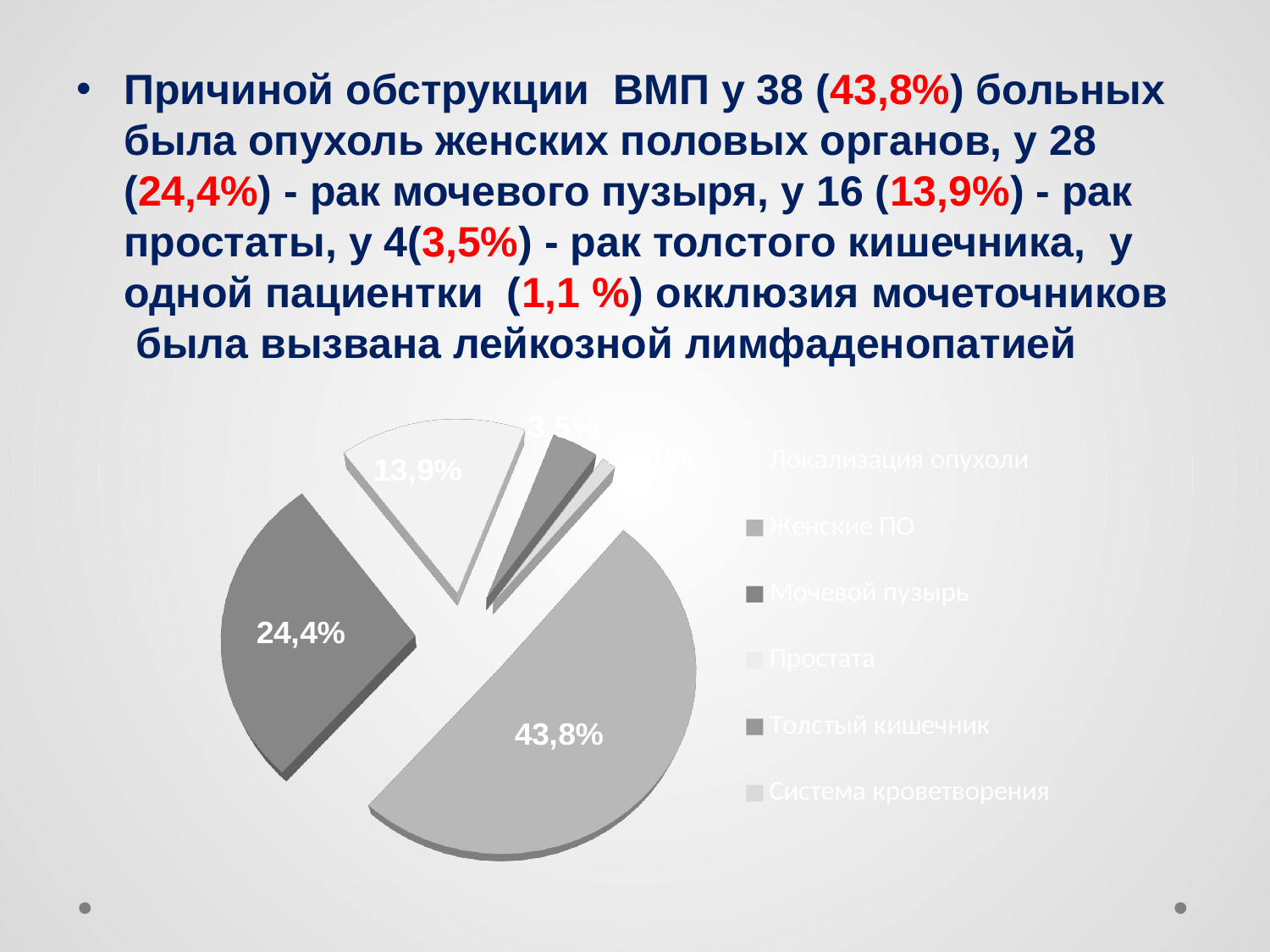
What is the title of the chart's legend? Локализация опухоли What is the difference in percentage points between the Женские ПО slice and the Мочевой пузырь slice? 19,4 What kind of chart is shown on the slide? pie chart What share of the pie does the largest slice (Женские ПО) take? 43,8% Which slice is larger: Мочевой пузырь or Простата? Мочевой пузырь Which category has the smallest slice of the pie? Система кроветворения Which category has the largest slice of the pie? Женские ПО What share of the pie does the slice for Мочевой пузырь take? 24,4% Is the share for Женские ПО greater or less than 50%? less What share of the pie does the slice for Толстый кишечник take? 3,5% What share of the pie does the slice for Простата take? 13,9% How many categories does the chart's legend list? 5